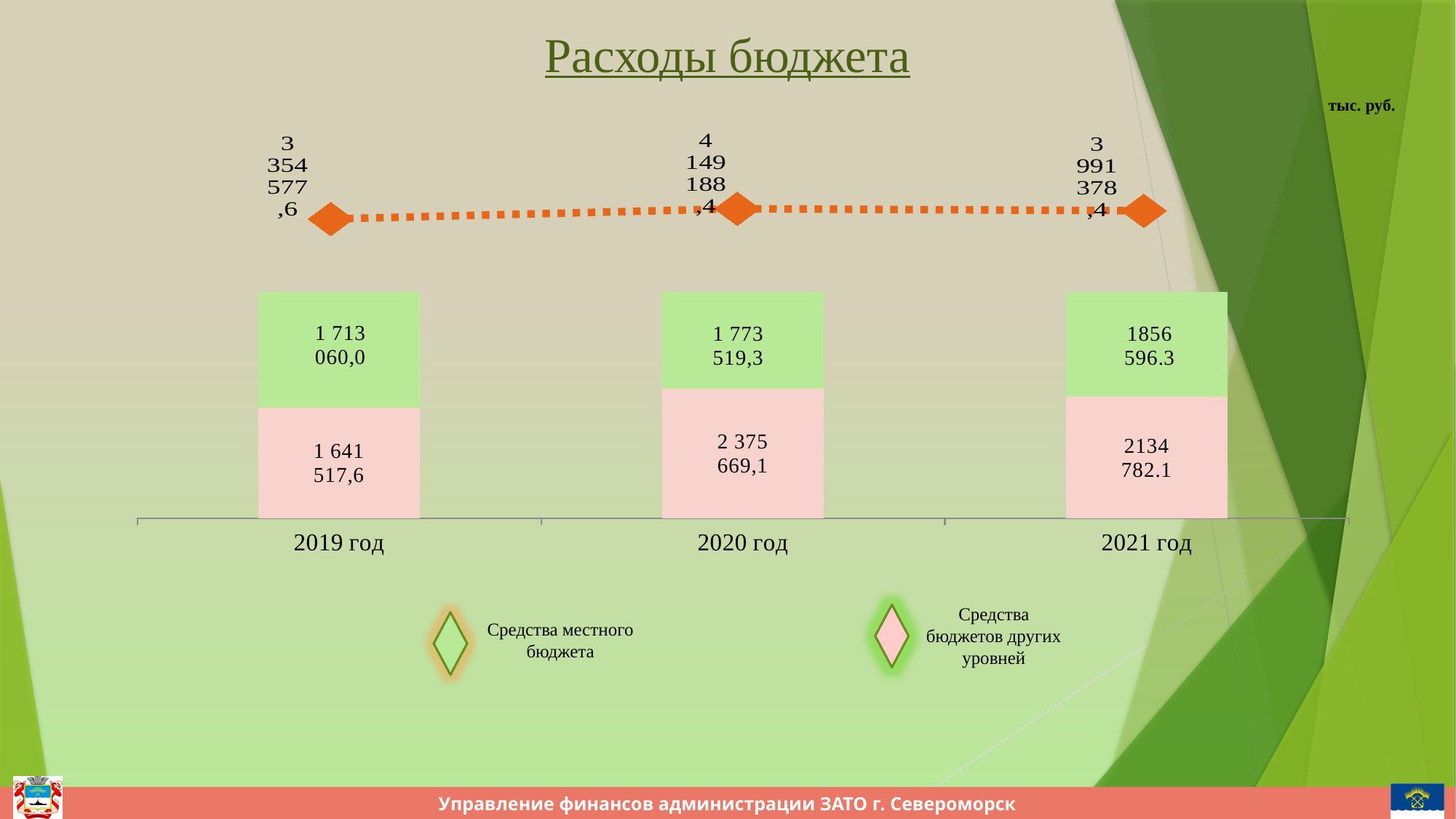
How many series does the legend list? 2 What is the value of Средства местного бюджета for 2019 год? 1 713 060,0 What is the total of the stacked bar for 2019 год? 3 354 577,6 What type of chart is used to show the budget expenditure by year? Stacked bar chart with a line What is the value of Средства местного бюджета for 2021 год? 1856 596.3 What total value is labelled on the line marker for 2020 год? 4 149 188,4 Which year has the highest value for Средства бюджетов других уровней? 2020 год How many year categories are shown on the x axis? 3 Which year has the lowest total labelled on the line? 2019 год Which is larger for 2021 год: Средства местного бюджета or Средства бюджетов других уровней? Средства бюджетов других уровней What is the title of the chart? Расходы бюджета What is the value of Средства бюджетов других уровней for 2020 год? 2 375 669,1